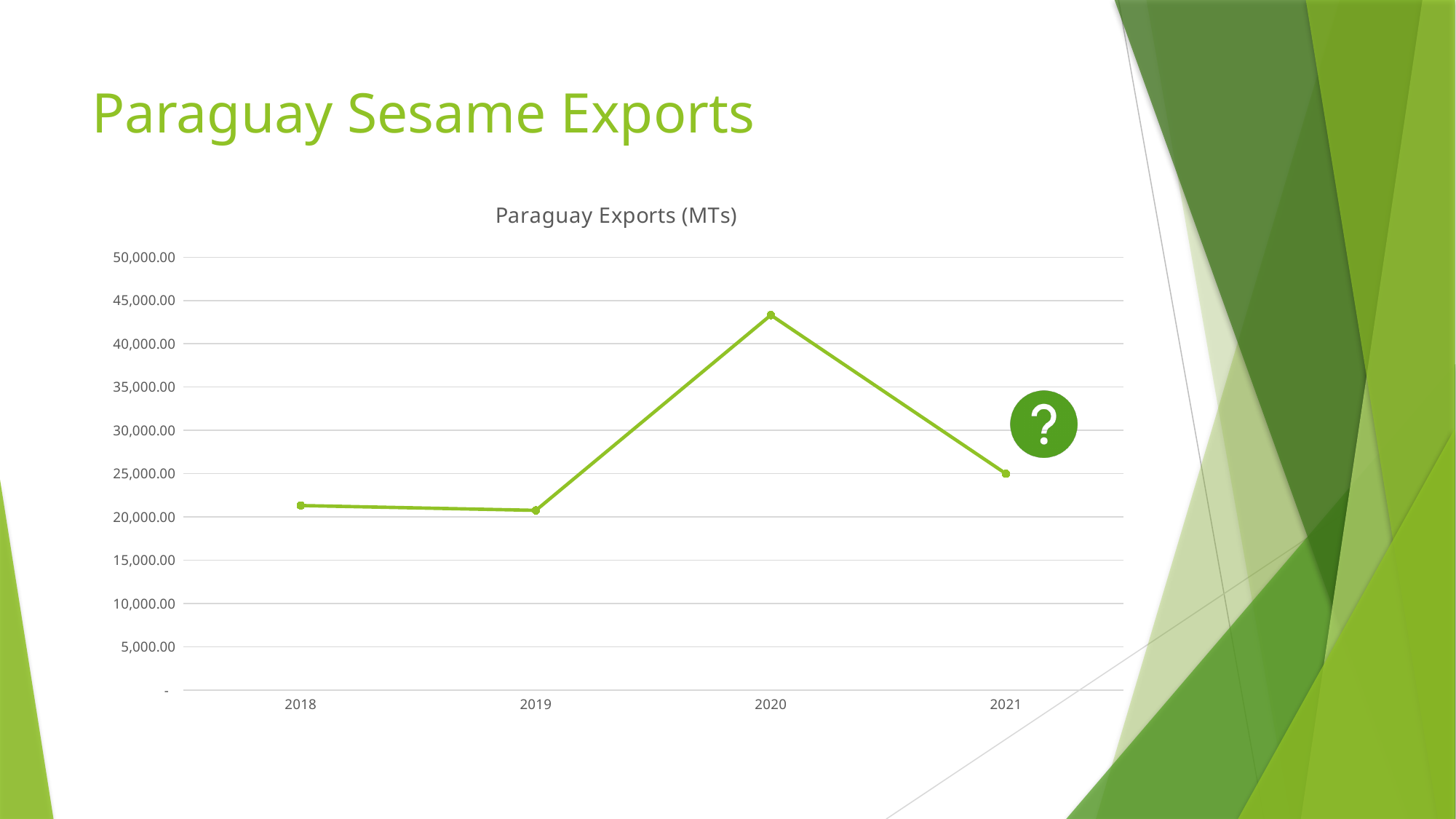
Is the value for 2020 greater or less than 40,000.00? greater Is the value for 2018 greater or less than 25,000.00? less Do exports rise or fall from 2020 to 2021? fall Is the value for 2019 greater or less than 20,000.00? greater Which year has the highest export value? 2020 How many years are plotted on the x axis? 4 Do exports rise or fall from 2019 to 2020? rise What is the title of the chart? Paraguay Exports (MTs) Which is larger, the value for 2018 or the value for 2021? 2021 What kind of chart is shown on the slide? line chart Which is larger, the value for 2020 or the value for 2021? 2020